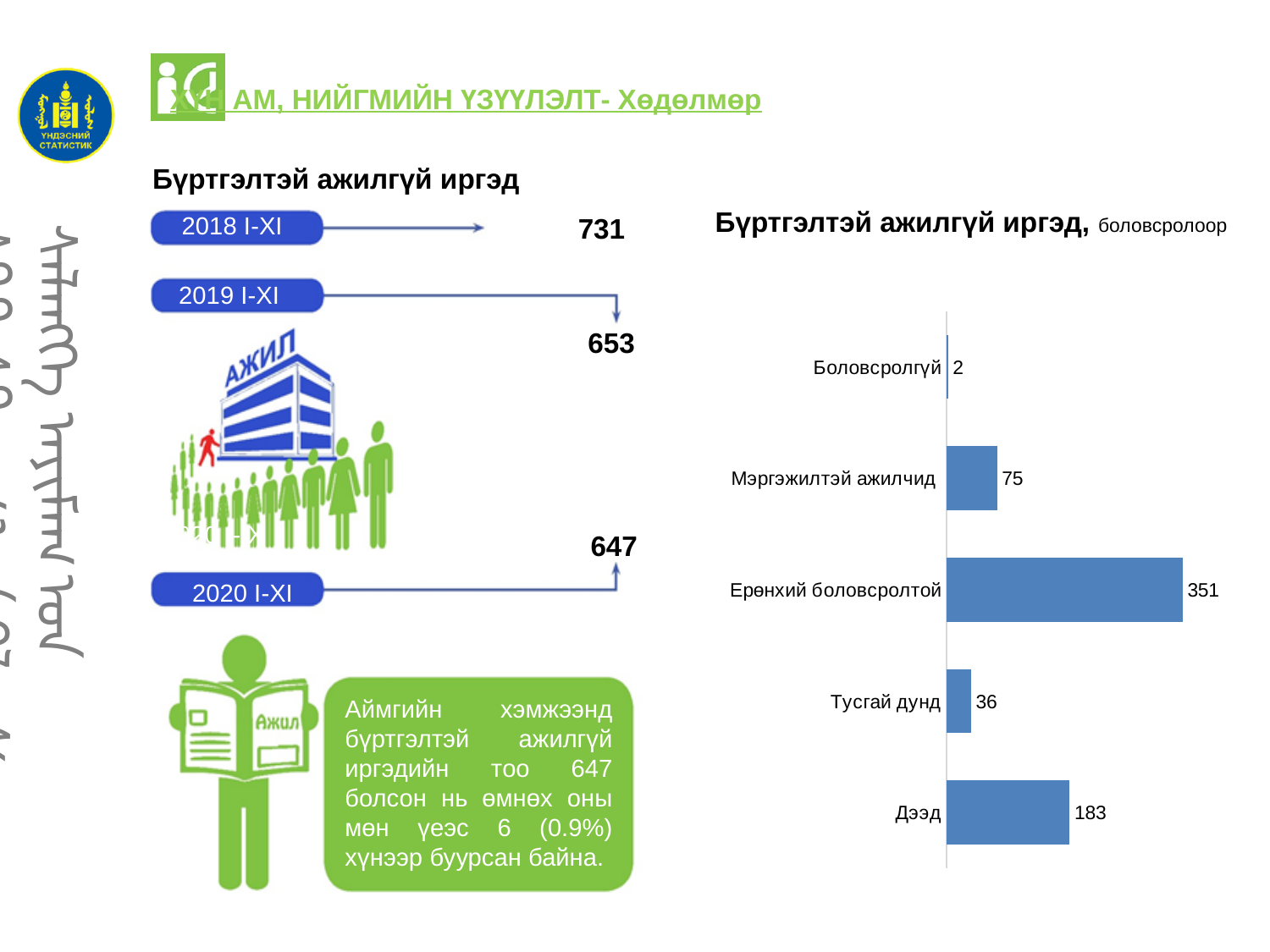
In the chart 'Бүртгэлтэй ажилгүй иргэд, боловсролоор', what is the difference between Ерөнхий боловсролтой and Дээд? 168 What type of chart is 'Бүртгэлтэй ажилгүй иргэд, боловсролоор'? Bar chart In the chart 'Бүртгэлтэй ажилгүй иргэд, боловсролоор', what is the value for Мэргэжилтэй ажилчид? 75 What is the value for Боловсролгүй in the chart 'Бүртгэлтэй ажилгүй иргэд, боловсролоор'? 2 In the chart 'Бүртгэлтэй ажилгүй иргэд, боловсролоор', what is the value for Ерөнхий боловсролтой? 351 How many categories are shown in the chart 'Бүртгэлтэй ажилгүй иргэд, боловсролоор'? 5 In the chart 'Бүртгэлтэй ажилгүй иргэд, боловсролоор', what is the value for Тусгай дунд? 36 In the chart 'Бүртгэлтэй ажилгүй иргэд, боловсролоор', which category has the lowest value? Боловсролгүй In the chart 'Бүртгэлтэй ажилгүй иргэд, боловсролоор', which is larger: Дээд or Мэргэжилтэй ажилчид? Дээд In the chart 'Бүртгэлтэй ажилгүй иргэд, боловсролоор', which category has the highest value? Ерөнхий боловсролтой In the chart 'Бүртгэлтэй ажилгүй иргэд, боловсролоор', what is the value for Дээд? 183 In the chart 'Бүртгэлтэй ажилгүй иргэд, боловсролоор', what is the difference between Мэргэжилтэй ажилчид and Тусгай дунд? 39